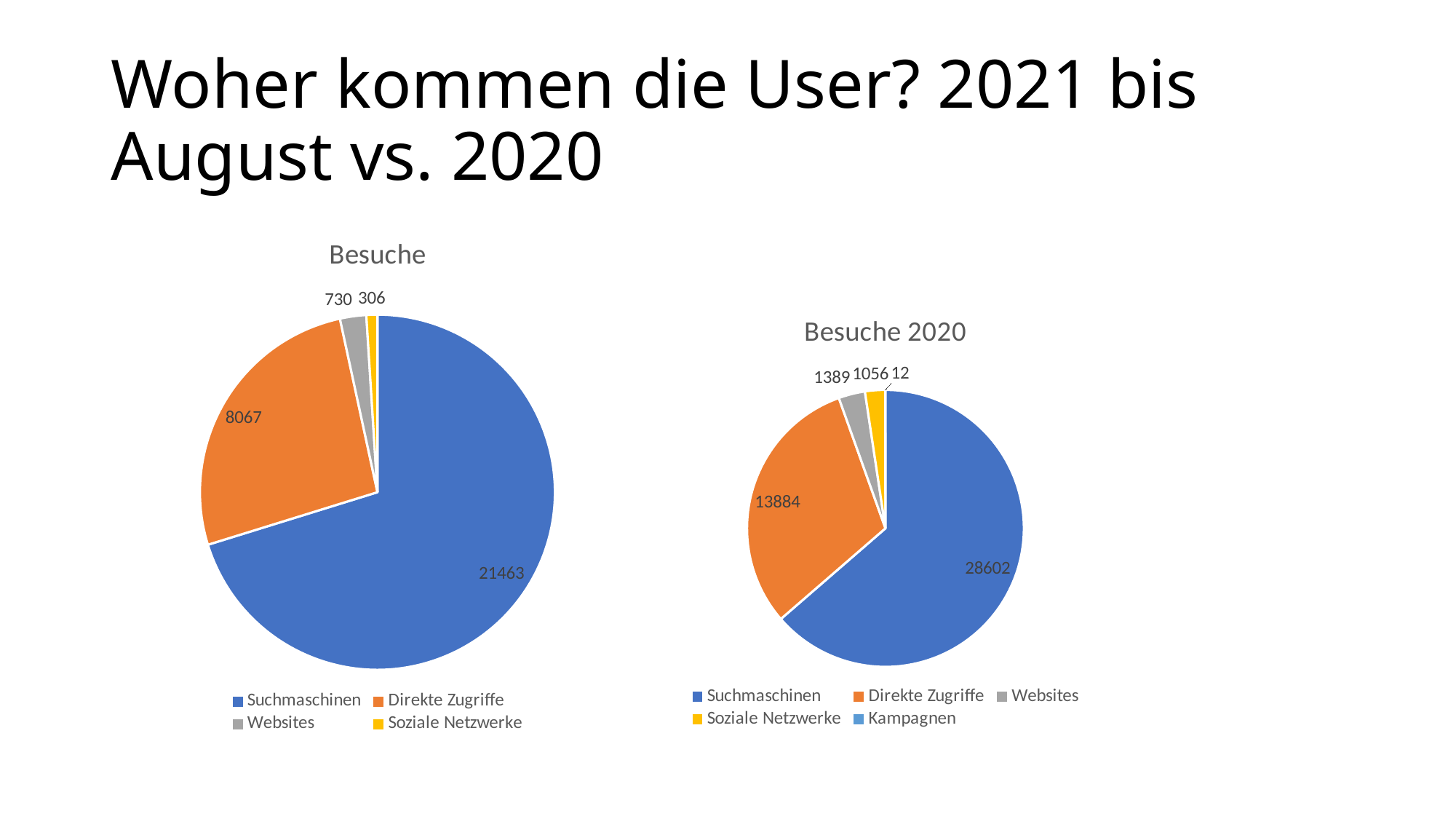
What is the difference between the Suchmaschinen value in the 'Besuche 2020' chart and the Suchmaschinen value in the 'Besuche' chart? 7139 How many categories does the legend of the 'Besuche 2020' pie chart list? 5 In the 'Besuche' pie chart, which category has the largest slice? Suchmaschinen In the 'Besuche 2020' pie chart, which category has the smallest slice? Kampagnen In the 'Besuche 2020' pie chart, what is the value for Kampagnen? 12 In the 'Besuche' pie chart, what is the value for Suchmaschinen? 21463 In the 'Besuche 2020' pie chart, what is the value for Direkte Zugriffe? 13884 What type of chart is used for 'Besuche 2020'? Pie chart In the 'Besuche' pie chart, what is the value for Soziale Netzwerke? 306 In the 'Besuche' pie chart, which is larger: Websites or Soziale Netzwerke? Websites How many categories does the legend of the 'Besuche' pie chart list? 4 In the 'Besuche 2020' pie chart, what is the difference between Direkte Zugriffe and Websites? 12495